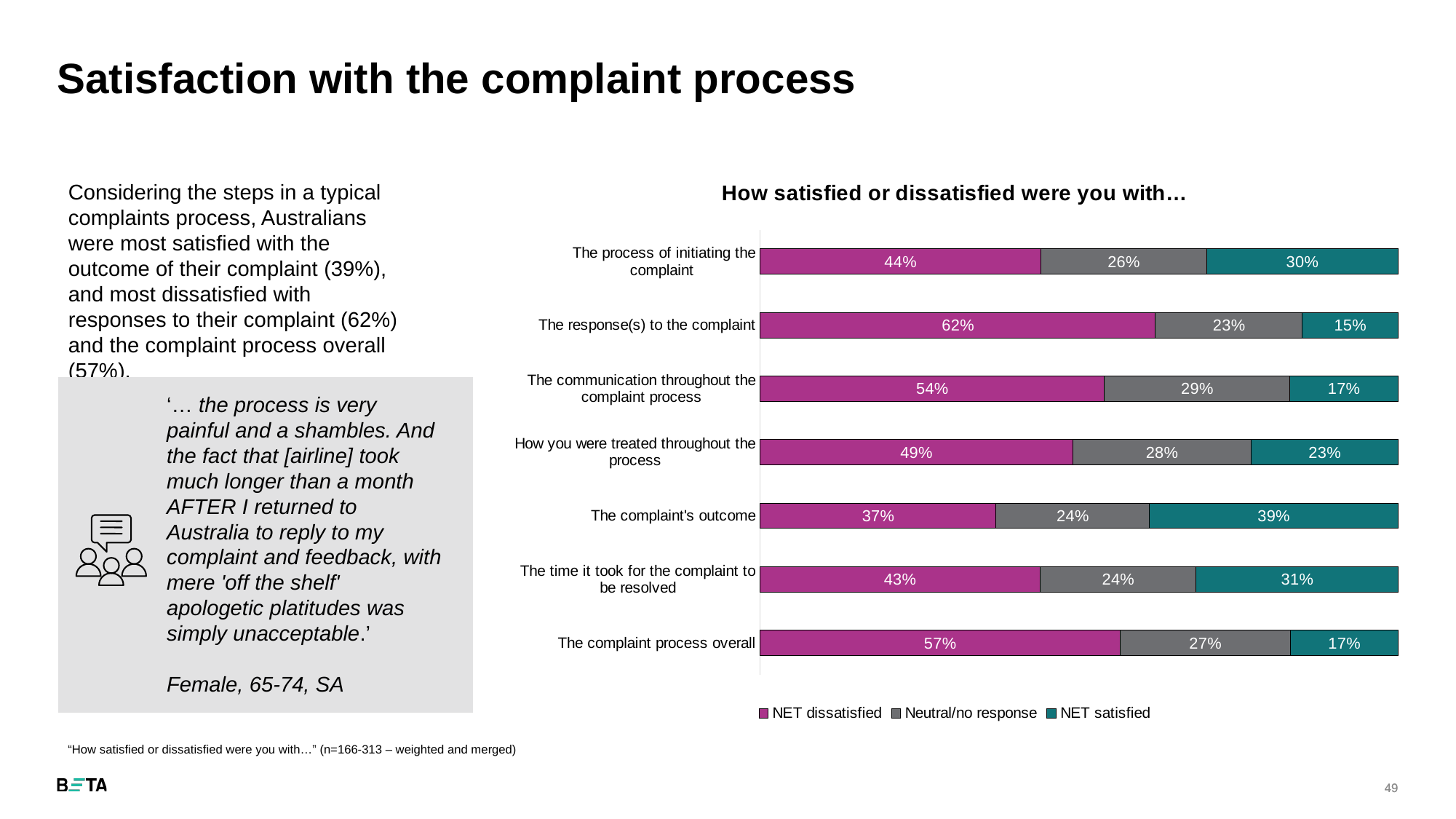
What percentage were NET dissatisfied with the response(s) to the complaint? 62% Which is larger: the NET satisfied share for the time it took for the complaint to be resolved or for the process of initiating the complaint? The time it took for the complaint to be resolved What is the difference between the NET dissatisfied percentages for the complaint process overall and the complaint's outcome? 20% What is the Neutral/no response share for the communication throughout the complaint process? 29% How many categories are shown in the chart? 7 What percentage were NET satisfied with the complaint's outcome? 39% What is the total of the three segments for the bar 'How you were treated throughout the process'? 100% What is the title of the chart? How satisfied or dissatisfied were you with… How many series does the legend list? 3 Which category has the highest NET dissatisfied percentage? The response(s) to the complaint Which category has the lowest NET satisfied percentage? The response(s) to the complaint What kind of chart is shown on the slide? Stacked bar chart